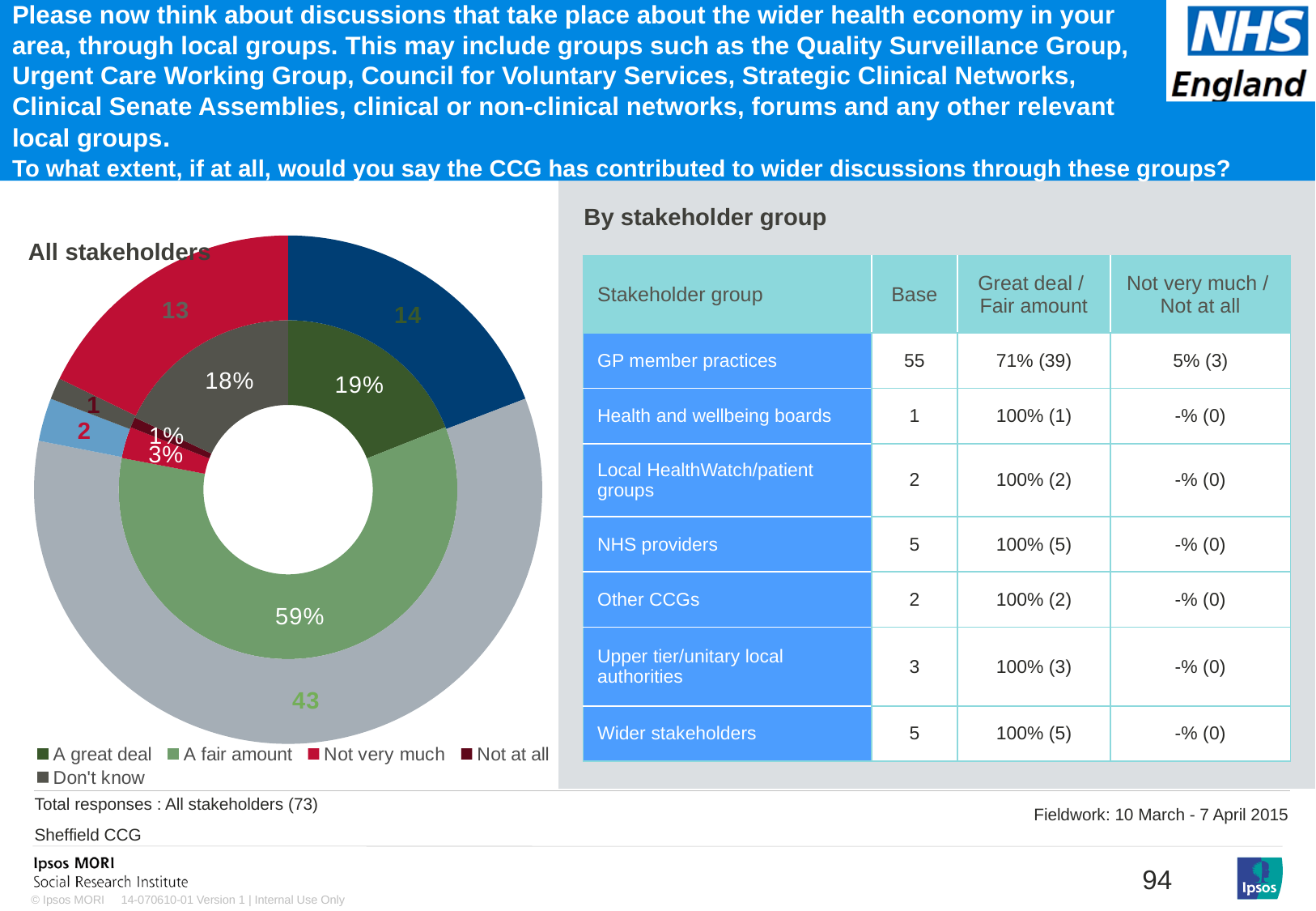
In the 'All stakeholders' chart, what percentage of respondents said 'A great deal'? 19% In the 'All stakeholders' chart, what percentage of respondents said 'A fair amount'? 59% In the 'All stakeholders' chart, what percentage of respondents said 'Not very much'? 3% In the 'All stakeholders' chart, which response category has the largest share? A fair amount In the 'All stakeholders' chart, what is the combined percentage for 'A great deal' and 'A fair amount'? 78% What kind of chart is shown under the heading 'All stakeholders'? Doughnut chart How many response categories does the legend of the 'All stakeholders' chart list? 5 In the 'All stakeholders' chart, what percentage of respondents said 'Not at all'? 1% In the 'All stakeholders' chart, what is the difference in percentage points between 'A fair amount' and 'A great deal'? 40 In the 'All stakeholders' chart, which is larger: the share for 'A great deal' or the share for 'Don't know'? A great deal In the 'All stakeholders' chart, what percentage of respondents said 'Don't know'? 18% In the 'All stakeholders' chart, which response category has the smallest share? Not at all